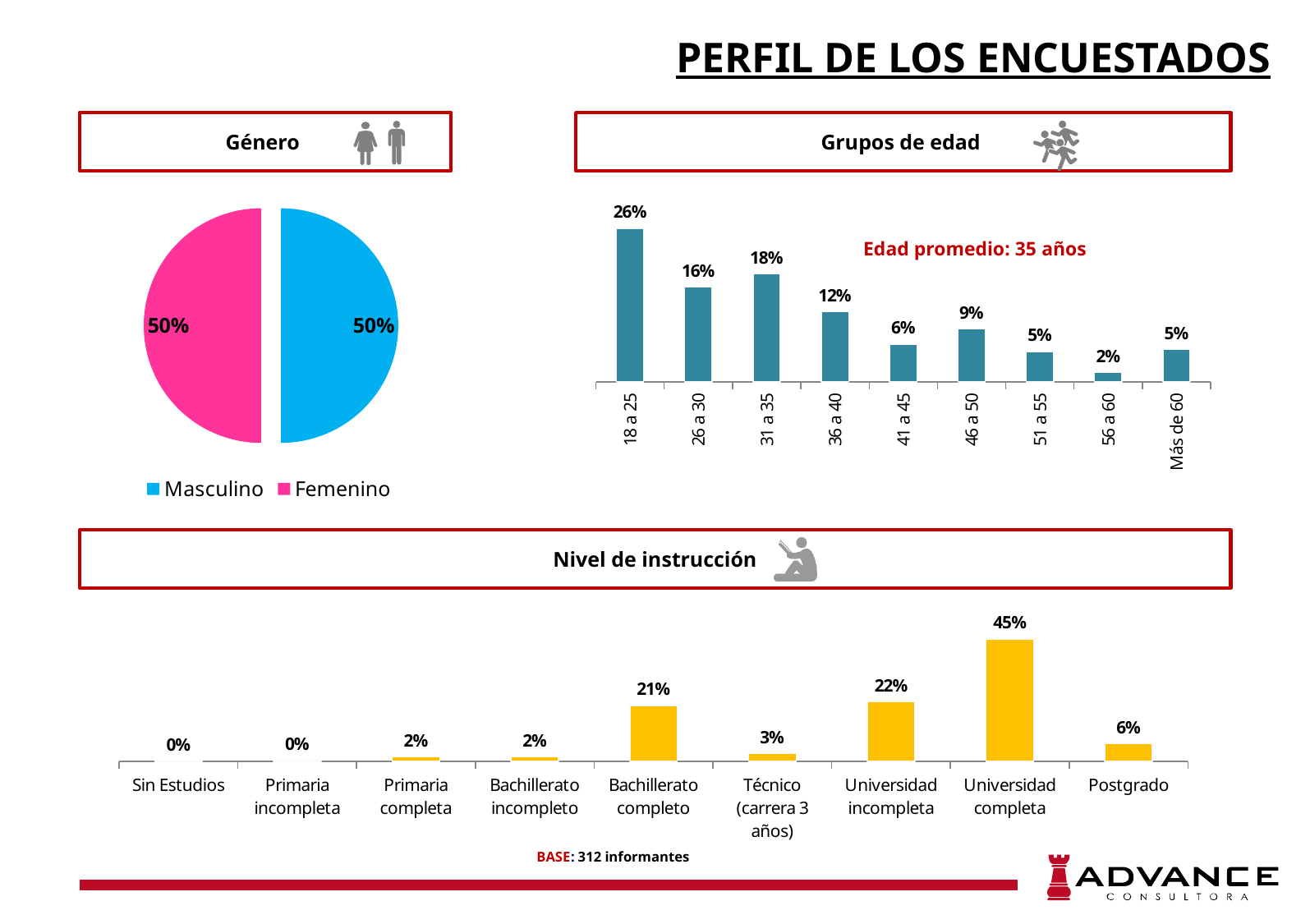
What kind of chart is the Género chart? pie chart In the Nivel de instrucción chart, what is the value for Universidad completa? 45% In the Grupos de edad chart, what is the difference between the values for 31 a 35 and 36 a 40? 6% In the Nivel de instrucción chart, what is the difference between Universidad completa and Postgrado? 39% In the Grupos de edad chart, which age group has the highest value? 18 a 25 How many age groups are shown in the Grupos de edad chart? 9 In the Nivel de instrucción chart, which is larger: Bachillerato completo or Universidad incompleta? Universidad incompleta In the Grupos de edad chart, what is the value for the 18 a 25 group? 26% What kind of chart is the Nivel de instrucción chart? bar chart In the Género chart, what share of respondents are Femenino? 50% In the Grupos de edad chart, which age group has the lowest value? 56 a 60 How many series does the legend of the Género chart list? 2